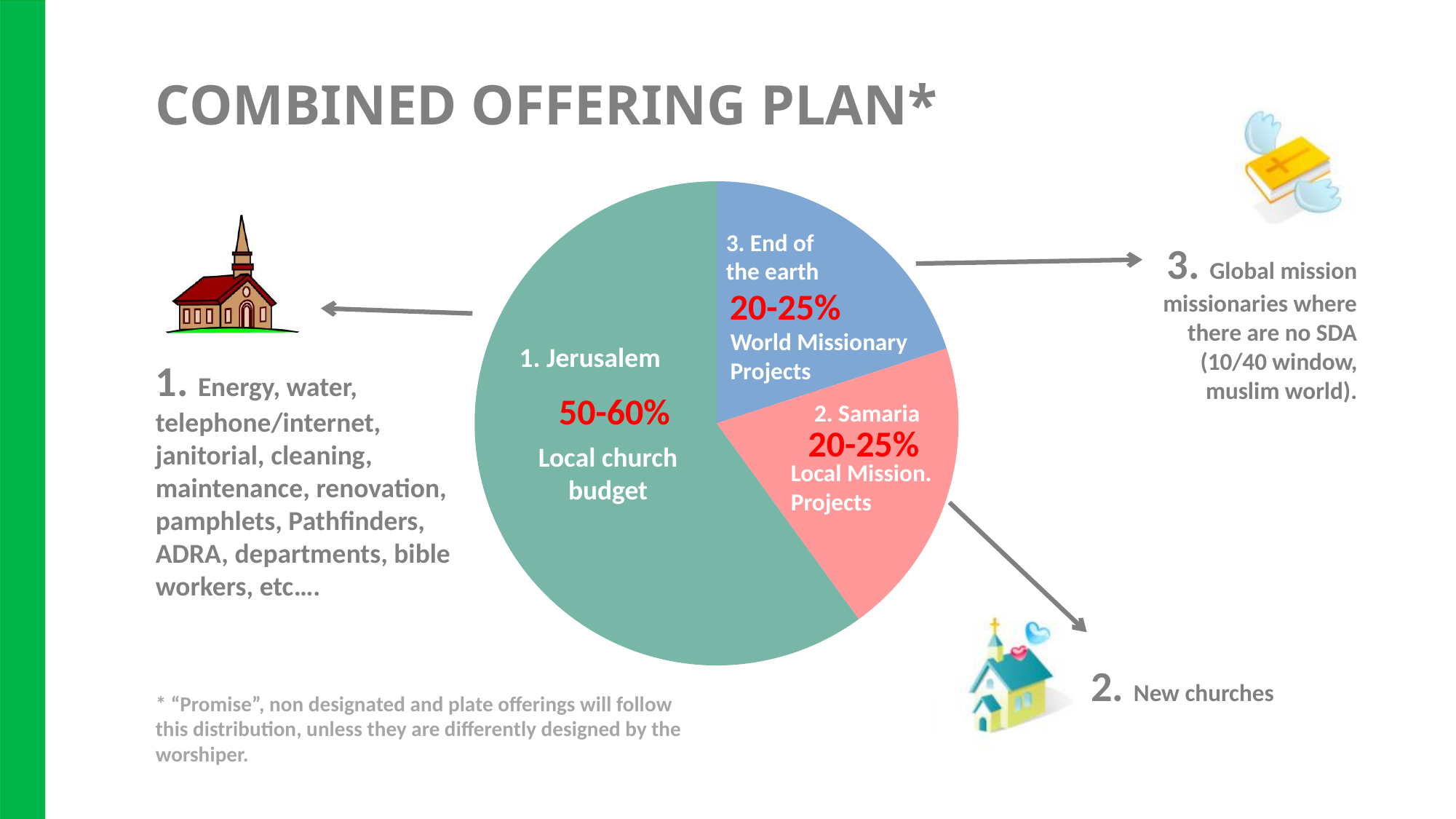
What is the title of the slide containing the pie chart? COMBINED OFFERING PLAN* What description is printed under the percentage in the End of the earth slice? World Missionary Projects What colour is the Samaria slice of the pie chart? pink What share of the pie is labelled for the "3. End of the earth" slice? 20-25% Which is larger, the End of the earth slice or the Jerusalem slice? Jerusalem What share of the pie is labelled for the "1. Jerusalem" slice? 50-60% Which is larger, the Jerusalem slice or the Samaria slice? Jerusalem What kind of chart is shown on the slide? pie chart What description is printed under the percentage in the Jerusalem slice? Local church budget How many slices does the pie chart have? 3 What share of the pie is labelled for the "2. Samaria" slice? 20-25% Which slice of the pie chart is the largest? 1. Jerusalem